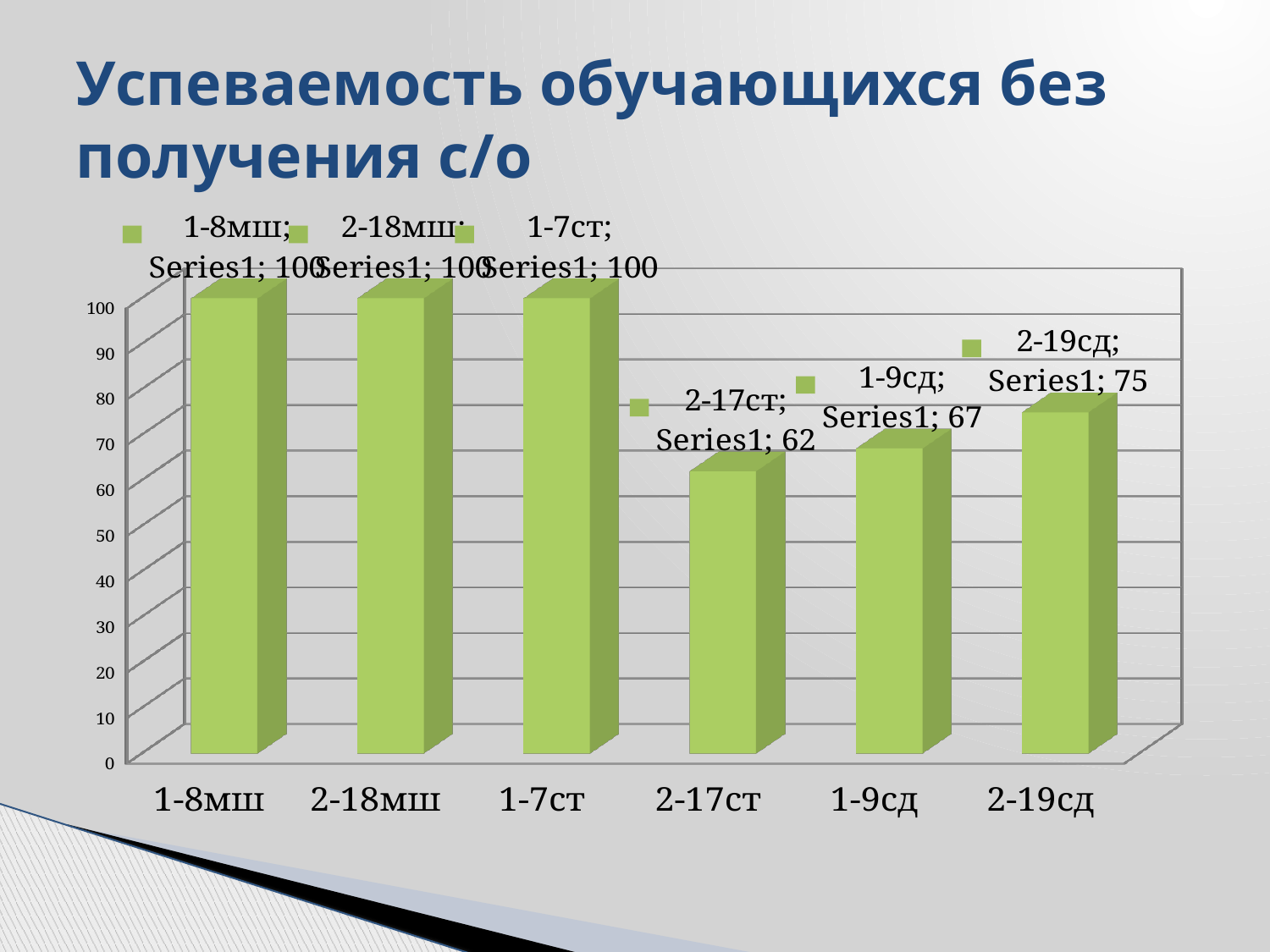
What is the title of the slide? Успеваемость обучающихся без получения с/о How many categories have a value of 100? 3 What is the difference between the values for 1-8мш and 1-9сд? 33 What is the value for 2-17ст? 62 What is the value for 1-9сд? 67 Which is larger, the value for 1-9сд or the value for 2-19сд? 2-19сд What is the difference between the values for 2-19сд and 2-17ст? 13 What is the value for 1-7ст? 100 How many categories are shown on the x axis? 6 Which category has the lowest value? 2-17ст What is the value for 2-19сд? 75 What kind of chart is shown on the slide? bar chart